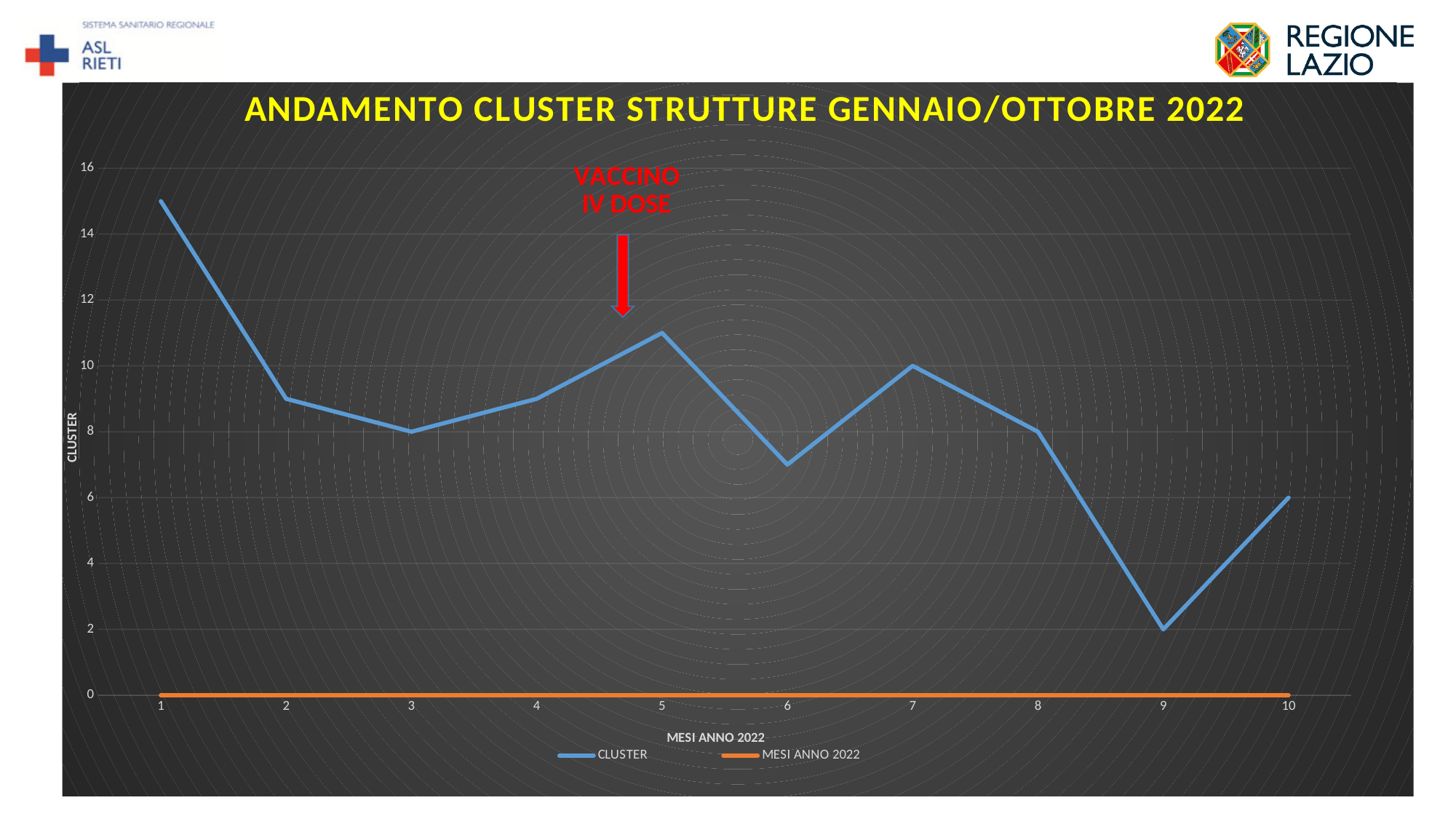
Does the CLUSTER line rise or fall from month 1 to month 3? fall What is the title of the chart? ANDAMENTO CLUSTER STRUTTURE GENNAIO/OTTOBRE 2022 How many months are plotted on the x axis? 10 What is the CLUSTER value for month 7? 10 Which month has the larger CLUSTER value, month 5 or month 6? month 5 In which month is the CLUSTER value lowest? 9 What kind of chart is shown on the slide? line chart How many series does the legend list? 2 What is the CLUSTER value for month 9? 2 In which month is the CLUSTER value highest? 1 Is the CLUSTER value for month 1 greater or less than 14? greater Is the CLUSTER value for month 6 greater or less than 8? less